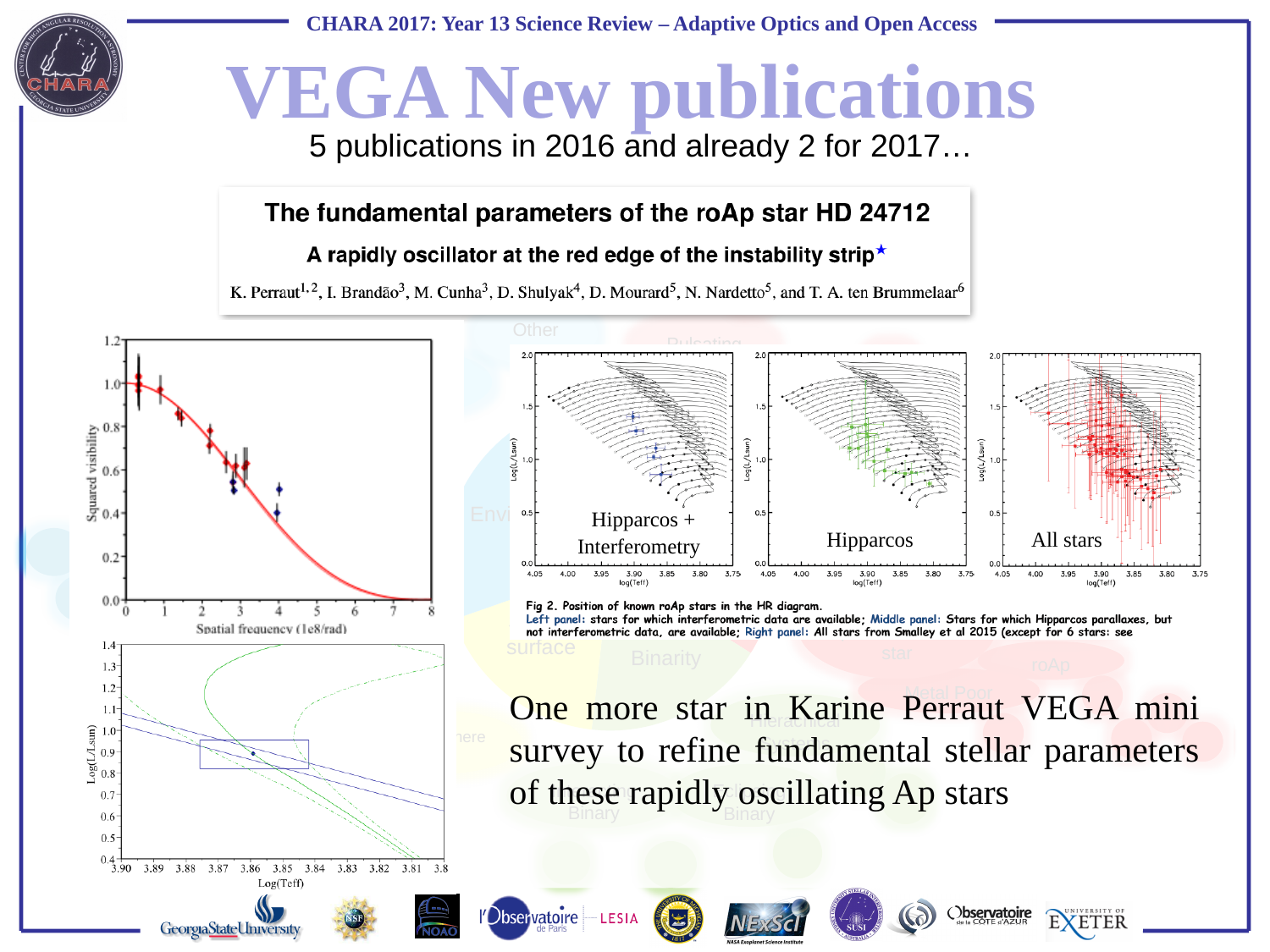
How many HR diagram panels are shown on the right side of the slide? 3 In the top-left chart, does the squared visibility rise or fall as spatial frequency increases? fall In the top-left chart, what quantity is plotted on the y-axis? Squared visibility In the top-left chart, are the data points at a spatial frequency of 4 greater or less than 0.6 in squared visibility? less In the top-left chart, what is the label of the x-axis? Spatial frequency (1e8/rad) In the bottom-left chart, is the Log(L/Lsun) value of the plotted point greater or less than 1.0? less What kind of chart is the top-left plot of squared visibility versus spatial frequency? scatter plot with a fitted curve What is the label of the leftmost HR diagram panel? Hipparcos + Interferometry What is the label of the rightmost HR diagram panel? All stars In the HR diagram panels, what is the maximum value shown on the Log(L/Lsun) axis? 2.0 In the top-left chart, is the squared visibility of the first data point (near spatial frequency 0) greater or less than 0.8? greater In the bottom-left chart, what is the label of the x-axis? Log(Teff)